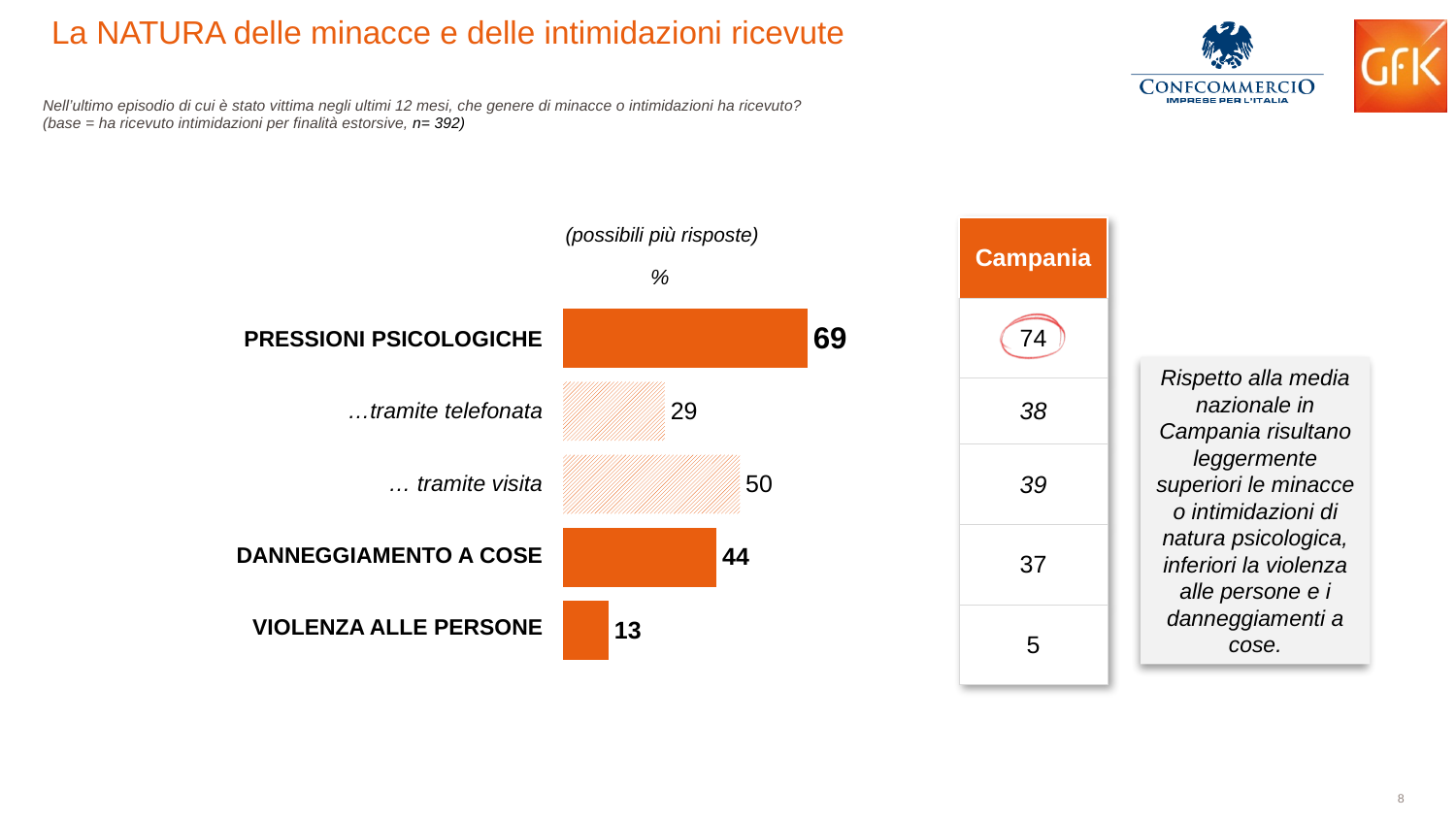
What is the Campania value shown for VIOLENZA ALLE PERSONE in the table next to the chart? 5 How many categories are shown in the bar chart? 5 What is the difference between the PRESSIONI PSICOLOGICHE value in the bar chart and the corresponding Campania value in the table? 5 What is the value for PRESSIONI PSICOLOGICHE in the bar chart? 69 Which category has the highest value in the bar chart? PRESSIONI PSICOLOGICHE What is the value for VIOLENZA ALLE PERSONE in the bar chart? 13 What is the value for '… tramite visita' in the bar chart? 50 Which is larger in the bar chart: DANNEGGIAMENTO A COSE or VIOLENZA ALLE PERSONE? DANNEGGIAMENTO A COSE What is the difference between the values for '… tramite visita' and '…tramite telefonata' in the bar chart? 21 Which category has the lowest value in the bar chart? VIOLENZA ALLE PERSONE What is the value for DANNEGGIAMENTO A COSE in the bar chart? 44 What kind of chart is shown on the slide? Bar chart